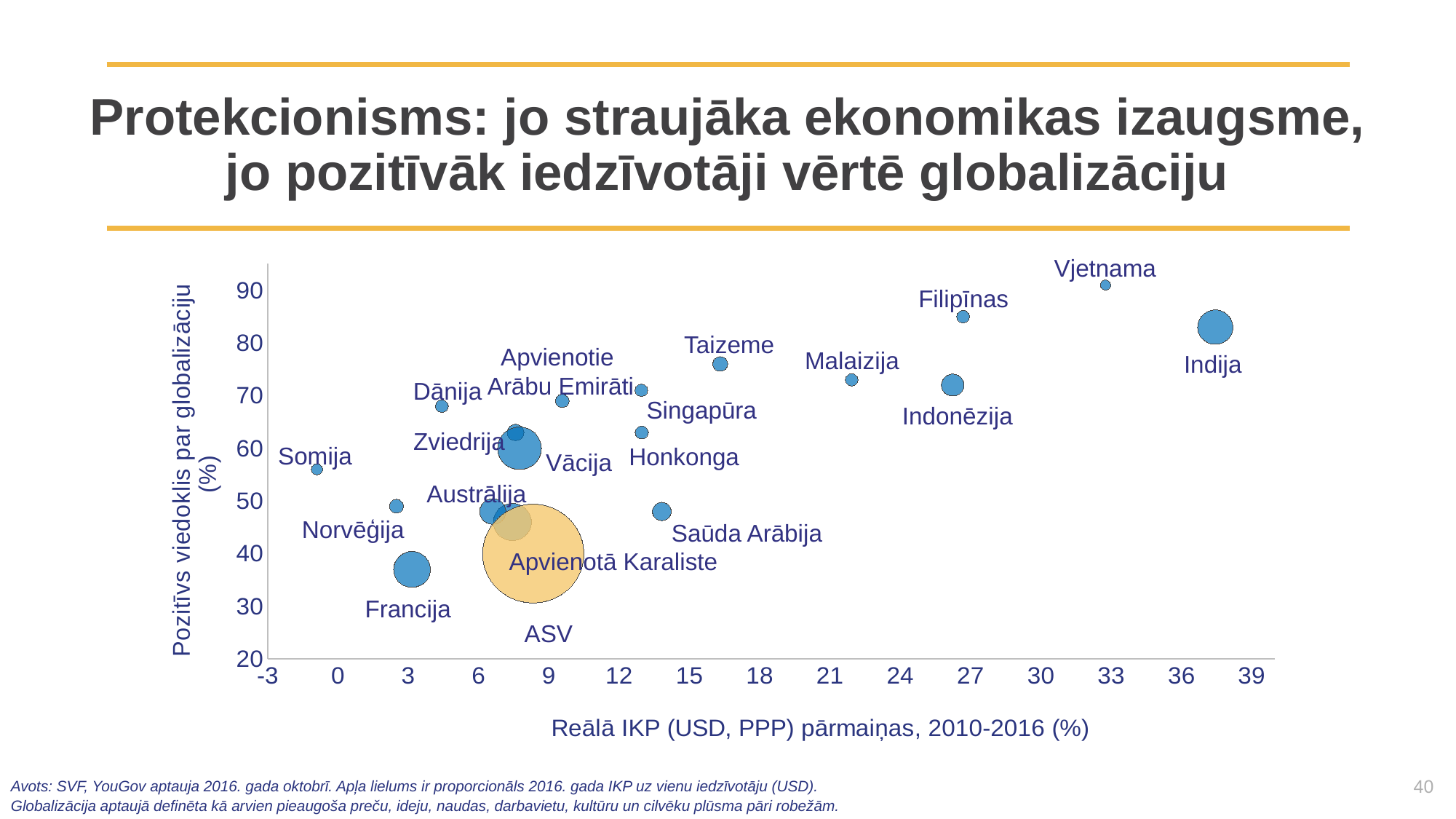
How many countries are plotted on the chart? 19 Is the real GDP change for Somija greater or less than 0? less Is the real GDP change for Indija greater or less than 36? greater Which country's bubble is coloured yellow instead of blue? Apvienotā Karaliste Which country has the highest real GDP change on the x axis? Indija Which country has the lowest real GDP change on the x axis? Somija Is the positive opinion value for Francija greater or less than 40? less Do positive opinions of globalisation generally rise or fall as real GDP change increases along the x axis? rise Which country has the highest positive opinion of globalisation (highest point on the y axis)? Vjetnama What kind of chart is shown on the slide? bubble chart Which has a higher positive opinion of globalisation, Taizeme or Honkonga? Taizeme